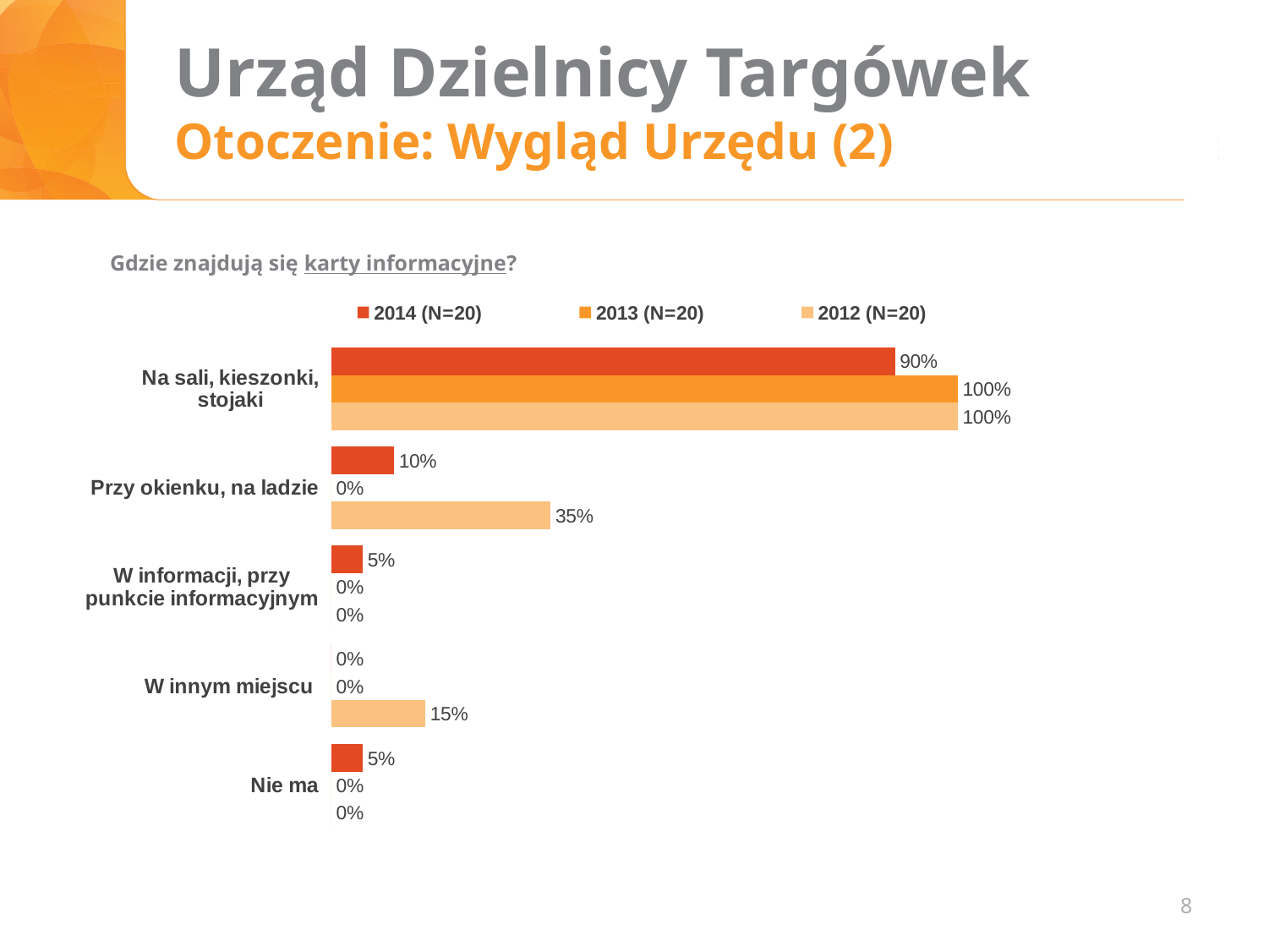
What is the value for 'W innym miejscu' in the 2012 (N=20) series? 15% What is the difference between the 2013 (N=20) and 2014 (N=20) values for 'Na sali, kieszonki, stojaki'? 10% Which category has the highest value in the 2014 (N=20) series? Na sali, kieszonki, stojaki What is the value for 'Na sali, kieszonki, stojaki' in the 2014 (N=20) series? 90% What question does the chart answer, as stated above it? Gdzie znajdują się karty informacyjne? How many categories are shown on the chart? 5 What is the value for 'Przy okienku, na ladzie' in the 2012 (N=20) series? 35% What kind of chart is shown on the slide? Bar chart What is the difference between the 2012 (N=20) and 2014 (N=20) values for 'Przy okienku, na ladzie'? 25% How many series does the legend list? 3 What is the value for 'Nie ma' in the 2014 (N=20) series? 5% Which is larger for 'Przy okienku, na ladzie': the 2014 (N=20) value or the 2012 (N=20) value? 2012 (N=20)